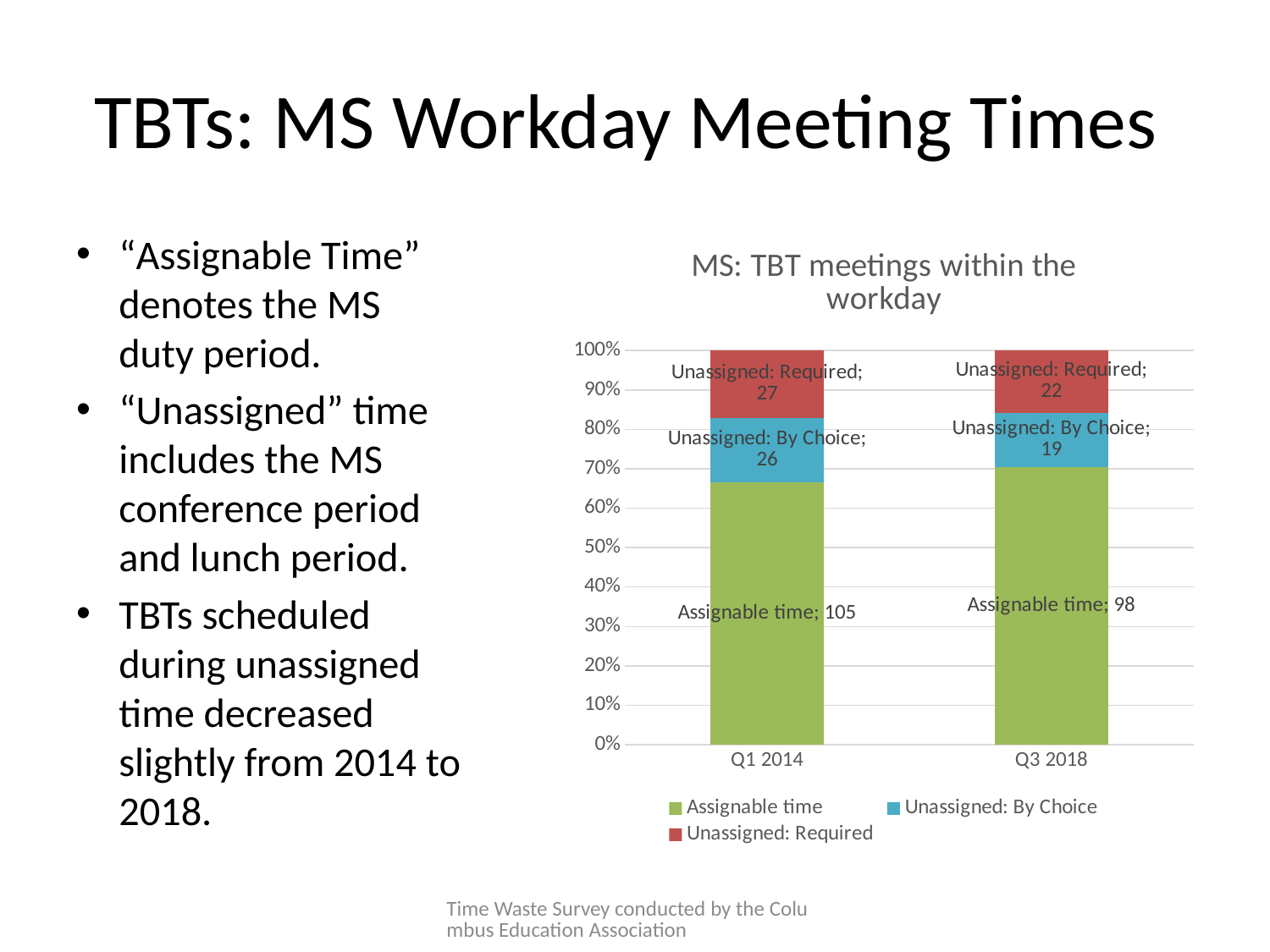
What is the value for Assignable time in Q1 2014? 105 Which period has the larger Unassigned: Required value, Q1 2014 or Q3 2018? Q1 2014 What is the value for Unassigned: Required in Q3 2018? 22 How many categories are shown on the x axis? 2 What is the value for Unassigned: By Choice in Q1 2014? 26 What is the difference between the Unassigned: By Choice values for Q1 2014 and Q3 2018? 7 What is the difference between the Assignable time values for Q1 2014 and Q3 2018? 7 What is the total of the three values in the Q1 2014 bar? 158 What is the title of the chart? MS: TBT meetings within the workday What is the value for Assignable time in Q3 2018? 98 How many series does the legend list? 3 What is the total of the three values in the Q3 2018 bar? 139